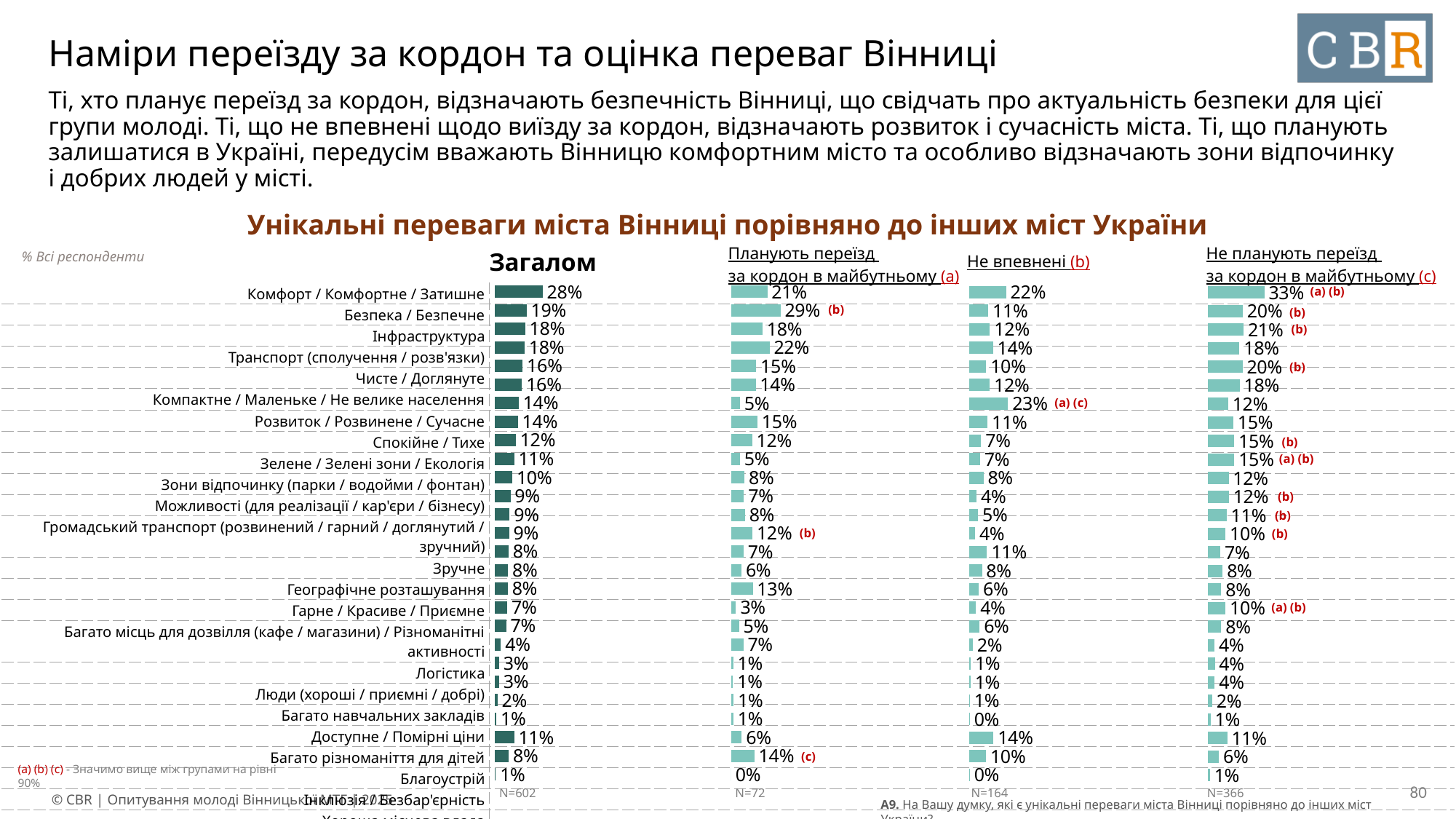
In the 'Не впевнені (b)' chart, which category has the highest value? Розвиток / Розвинене / Сучасне In the 'Планують переїзд за кордон в майбутньому (a)' chart, which category has the highest value? Безпека / Безпечне In the 'Не планують переїзд за кордон в майбутньому (c)' chart, what is the value for 'Комфорт / Комфортне / Затишне'? 33% In the 'Загалом' chart, what is the value for 'Комфорт / Комфортне / Затишне'? 28% What is the difference between the 'Комфорт / Комфортне / Затишне' value in the 'Не планують переїзд (c)' chart and in the 'Планують переїзд (a)' chart? 12 percentage points Is the value for 'Безпека / Безпечне' larger in the 'Планують переїзд (a)' chart or in the 'Не впевнені (b)' chart? Планують переїзд (a) How many respondent groups (charts) are shown side by side on the slide? 4 What is the sample size (N) shown under the 'Загалом' chart? N=602 What kind of chart is used on this slide? Bar chart In the 'Не впевнені (b)' chart, what is the value for 'Інфраструктура'? 12% In the 'Загалом' chart, which category has the highest value? Комфорт / Комфортне / Затишне In the 'Планують переїзд за кордон в майбутньому (a)' chart, what is the value for 'Безпека / Безпечне'? 29%